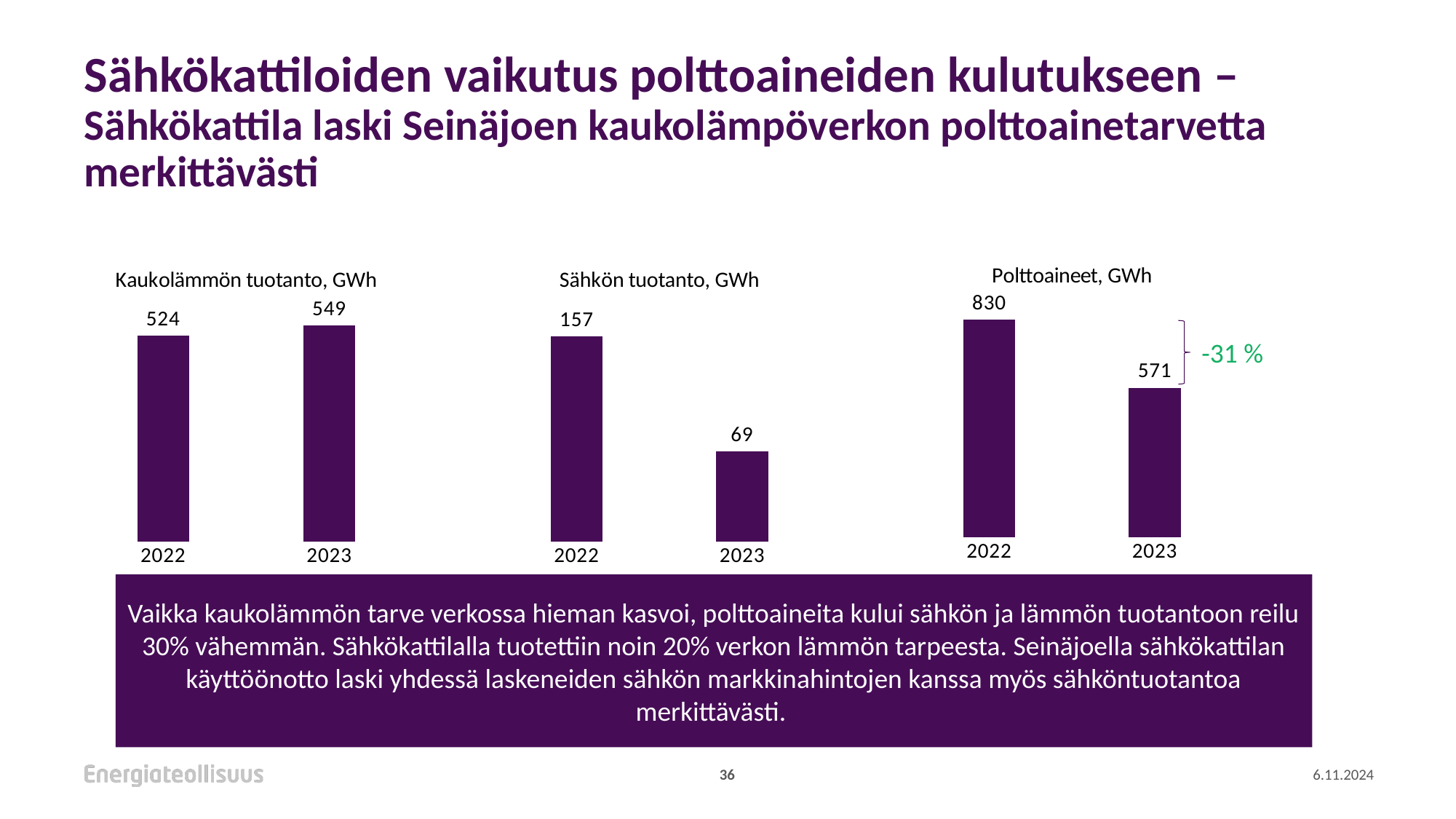
In the 'Polttoaineet, GWh' chart, what is the value for 2022? 830 What type of chart is the 'Polttoaineet, GWh' chart? bar chart In the 'Sähkön tuotanto, GWh' chart, what is the difference between the 2022 and 2023 values? 88 In the 'Sähkön tuotanto, GWh' chart, which year has the lower value? 2023 In the 'Kaukolämmön tuotanto, GWh' chart, which year has the higher value? 2023 In the 'Polttoaineet, GWh' chart, what is the difference between the 2022 and 2023 values? 259 In the 'Sähkön tuotanto, GWh' chart, do the values rise or fall from 2022 to 2023? fall In the 'Kaukolämmön tuotanto, GWh' chart, what is the value for 2022? 524 In the 'Polttoaineet, GWh' chart, is the value for 2022 larger or smaller than the value for 2023? larger In the 'Kaukolämmön tuotanto, GWh' chart, what is the value for 2023? 549 What percentage change is annotated next to the 'Polttoaineet, GWh' chart? -31 % In the 'Sähkön tuotanto, GWh' chart, what is the value for 2023? 69